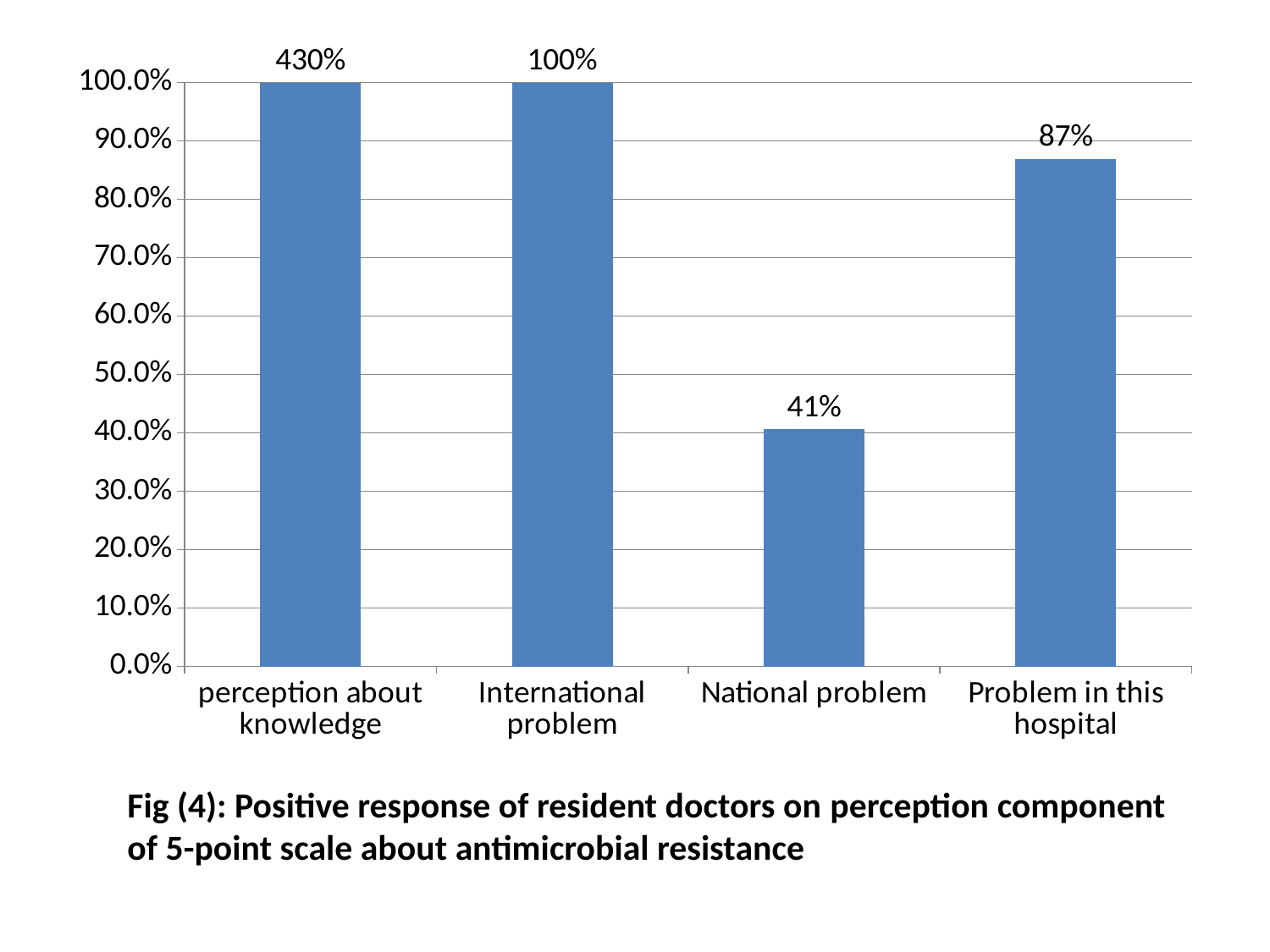
Which category has the lowest value? National problem How many categories are shown on the x axis? 4 What value is shown for National problem? 41% What figure number is given in the caption below the chart? Fig (4) What data label is printed above the bar for perception about knowledge? 430% What value is shown for International problem? 100% Is the value for National problem greater or less than 50.0%? less What is the difference between the values for Problem in this hospital and National problem? 46 percentage points What is the difference between the values for International problem and Problem in this hospital? 13 percentage points Which is larger, the value for National problem or the value for Problem in this hospital? Problem in this hospital What kind of chart is shown on the slide? bar chart What value is shown for Problem in this hospital? 87%